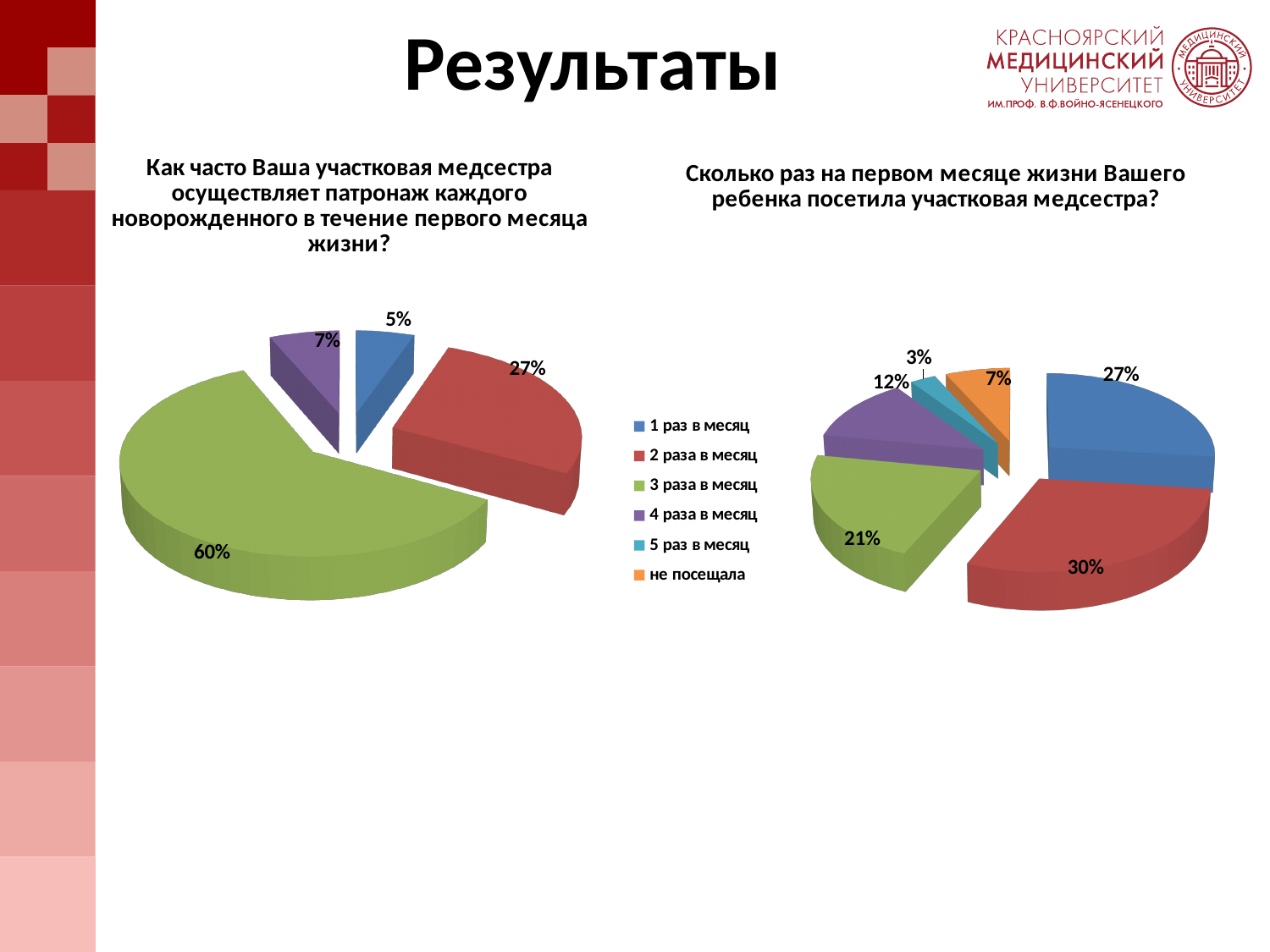
In the left pie chart, which category has the largest slice? 3 раза в месяц In the left pie chart, which category has the smallest slice? 1 раз в месяц In the right pie chart ("Сколько раз на первом месяце жизни Вашего ребенка посетила участковая медсестра?"), what share is shown for "2 раза в месяц"? 30% What type of chart is used on the left side of the slide? Pie chart How many entries does the legend between the two charts list? 6 How many slices does the right pie chart have? 6 In the right pie chart, which is larger: the slice for "1 раз в месяц" or the slice for "3 раза в месяц"? 1 раз в месяц In the left pie chart ("Как часто Ваша участковая медсестра осуществляет патронаж..."), what share is shown for "3 раза в месяц"? 60% In the right pie chart, which category has the smallest slice? 5 раз в месяц In the left pie chart, what share is shown for "1 раз в месяц"? 5% In the left pie chart, what is the difference between the shares for "2 раза в месяц" and "4 раза в месяц"? 20% In the right pie chart, what share is shown for "не посещала"? 7%